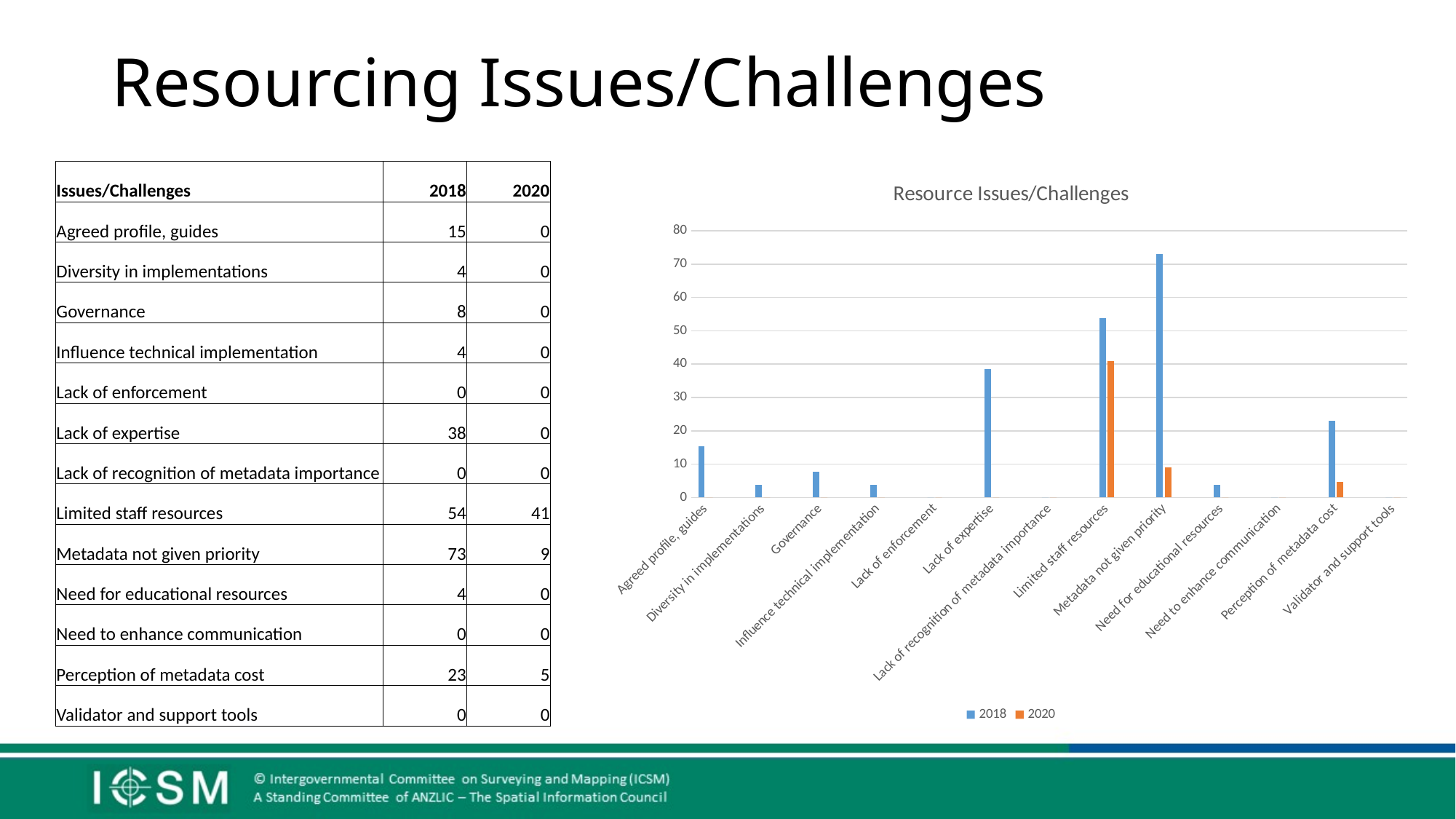
How many categories are shown on the x axis of the chart? 13 Which category has the highest 2018 value? Metadata not given priority What is the 2020 value for Limited staff resources? 41 What type of chart is shown on the slide? bar chart What is the title of the chart? Resource Issues/Challenges Which category has the highest 2020 value? Limited staff resources What is the 2018 value for Metadata not given priority? 73 Which is larger, the 2018 value for Lack of expertise or the 2018 value for Agreed profile, guides? Lack of expertise What is the difference between the 2018 and 2020 values for Perception of metadata cost? 18 Is the 2018 value for Limited staff resources greater or less than 50? greater What is the 2018 value for Governance? 8 How many series does the chart legend list? 2